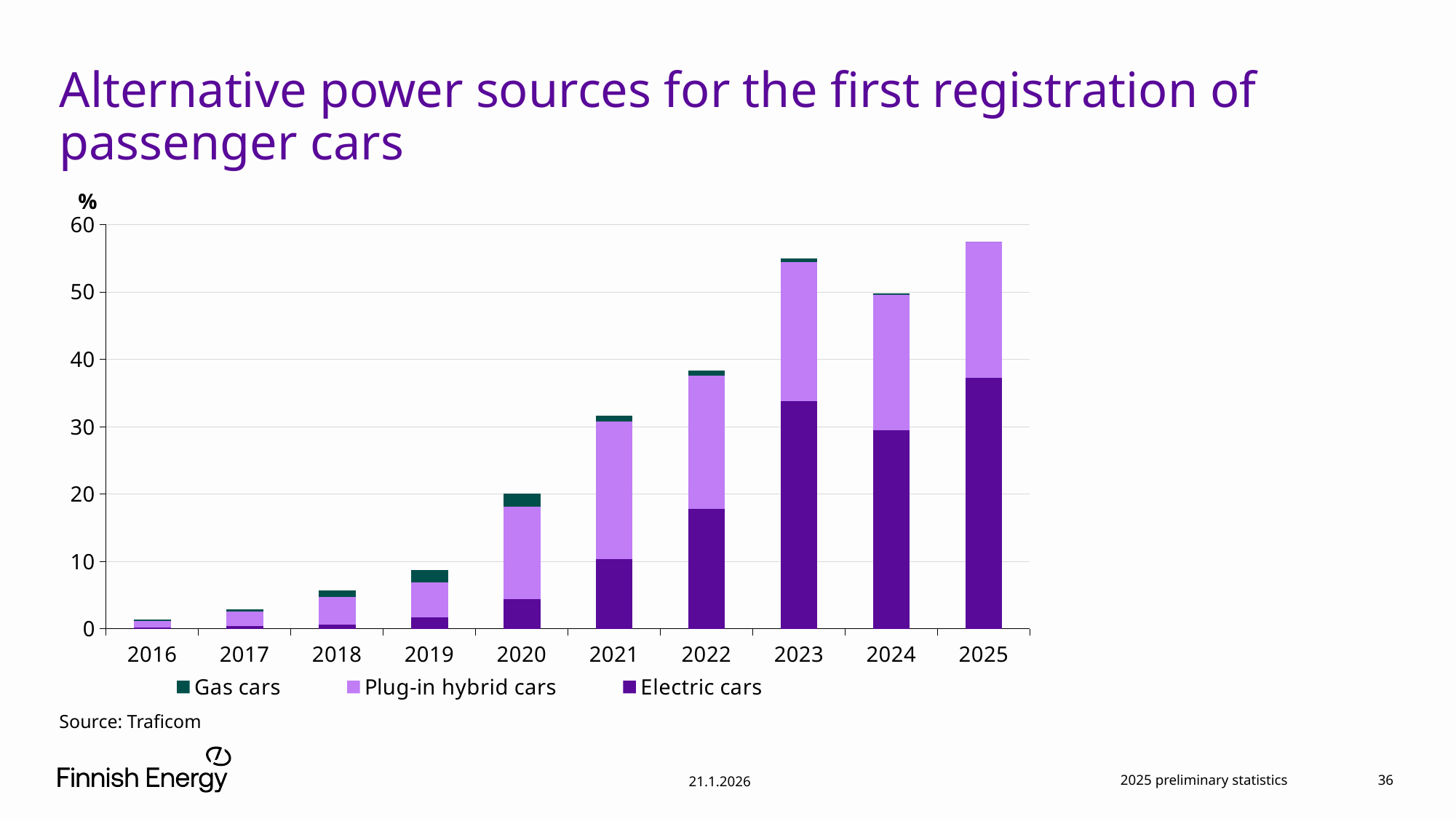
Is the total stacked value for 2025 greater or less than 50? greater How many series does the legend list? 3 Which year has the lowest total share of alternative power sources? 2016 Do the total values generally rise or fall from 2016 to 2025? rise Which year has the larger total stacked value, 2023 or 2024? 2023 What kind of chart is shown on the slide? Stacked bar chart How many years are shown on the x axis? 10 Which year has the highest total share of alternative power sources? 2025 What unit is shown on the y axis? % Is the total stacked value for 2022 greater or less than 40? less Is the Electric cars value for 2022 greater or less than 20? less